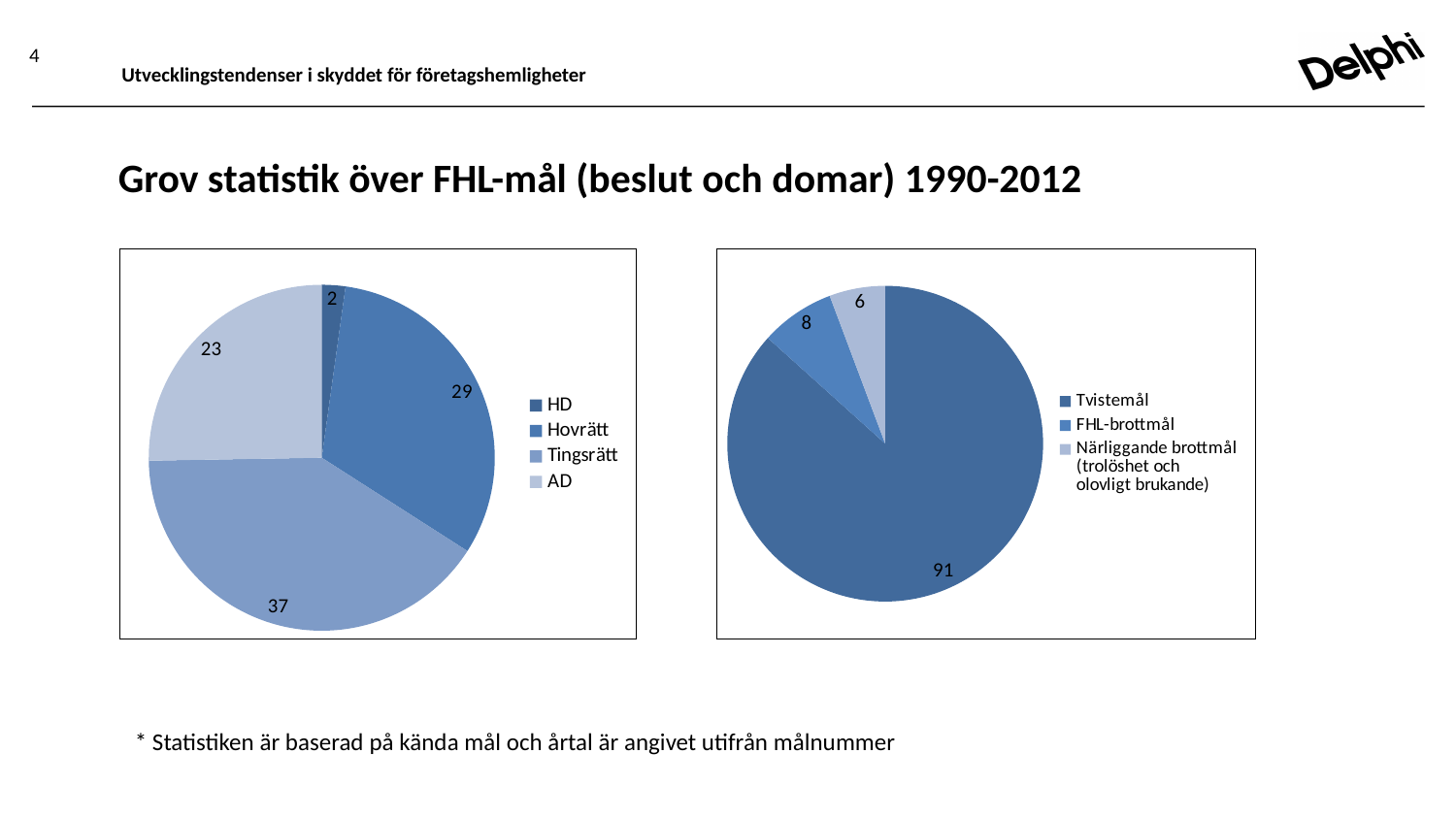
What is the total of all slices in the right pie chart? 105 On the right pie chart, what is the value for FHL-brottmål? 8 On the right pie chart, which is larger, FHL-brottmål or Närliggande brottmål? FHL-brottmål On the left pie chart, what is the value for HD? 2 How many categories does the left pie chart show? 4 On the right pie chart, what is the value for Tvistemål? 91 On the left pie chart, which category has the smallest slice? HD On the left pie chart, which category has the largest slice? Tingsrätt What type of chart is the right chart on the slide? Pie chart On the right pie chart, which category has the smallest slice? Närliggande brottmål (trolöshet och olovligt brukande) On the left pie chart, what is the difference between the values for Hovrätt and AD? 6 On the left pie chart, what is the value for Tingsrätt? 37